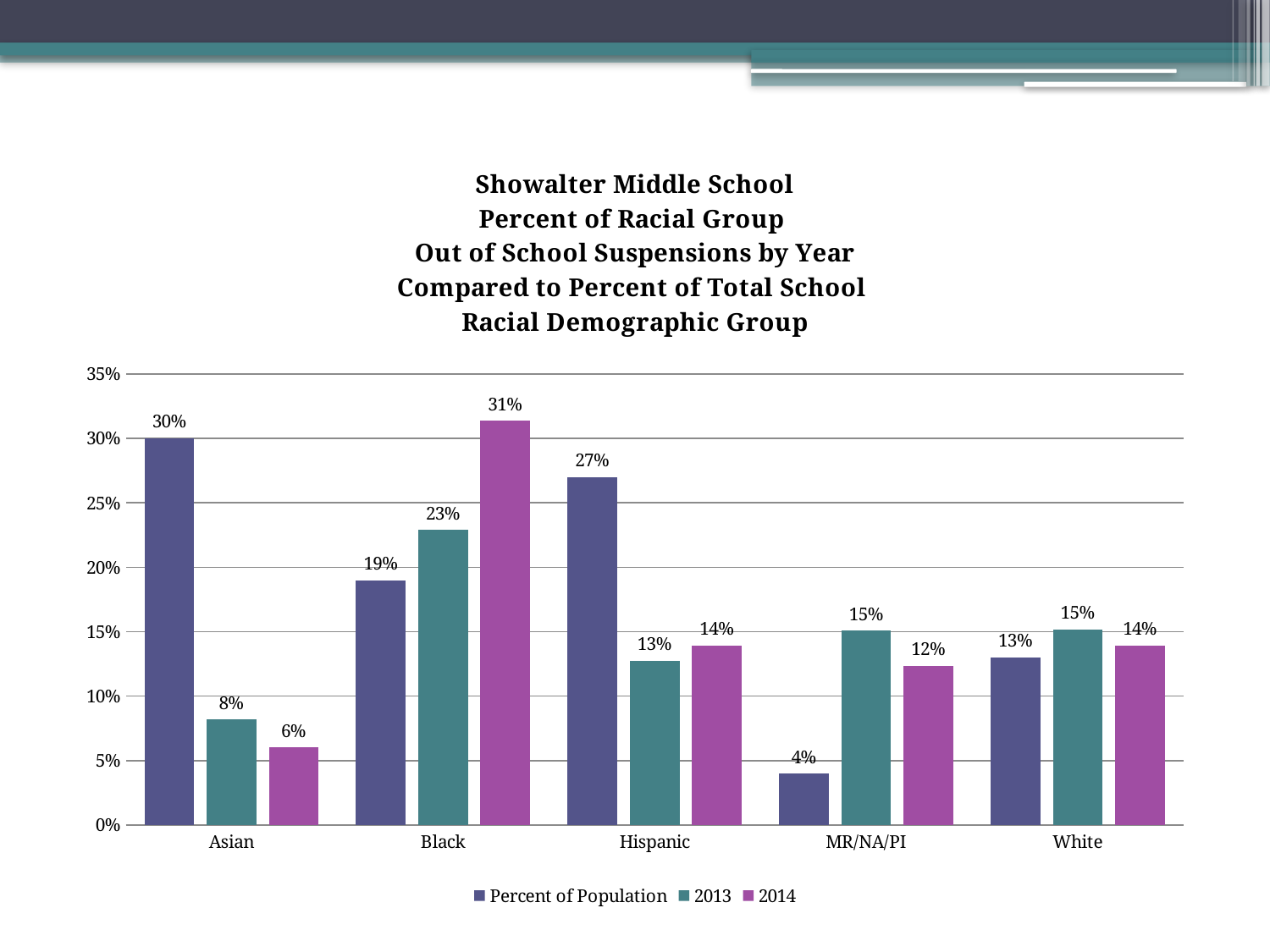
How many series does the legend list? 3 Which racial group has the highest 2014 value? Black How many racial groups are shown on the x axis? 5 What is the Percent of Population value for Asian? 30% Which is larger for Asian: the Percent of Population value or the 2013 value? Percent of Population What kind of chart is shown on the slide? Bar chart What is the 2013 value for Hispanic? 13% What is the 2014 value for Black? 31% What is the Percent of Population value for MR/NA/PI? 4% Which racial group has the lowest Percent of Population value? MR/NA/PI What is the name of the school in the chart title? Showalter Middle School What is the difference between the 2013 and 2014 values for Black? 8%